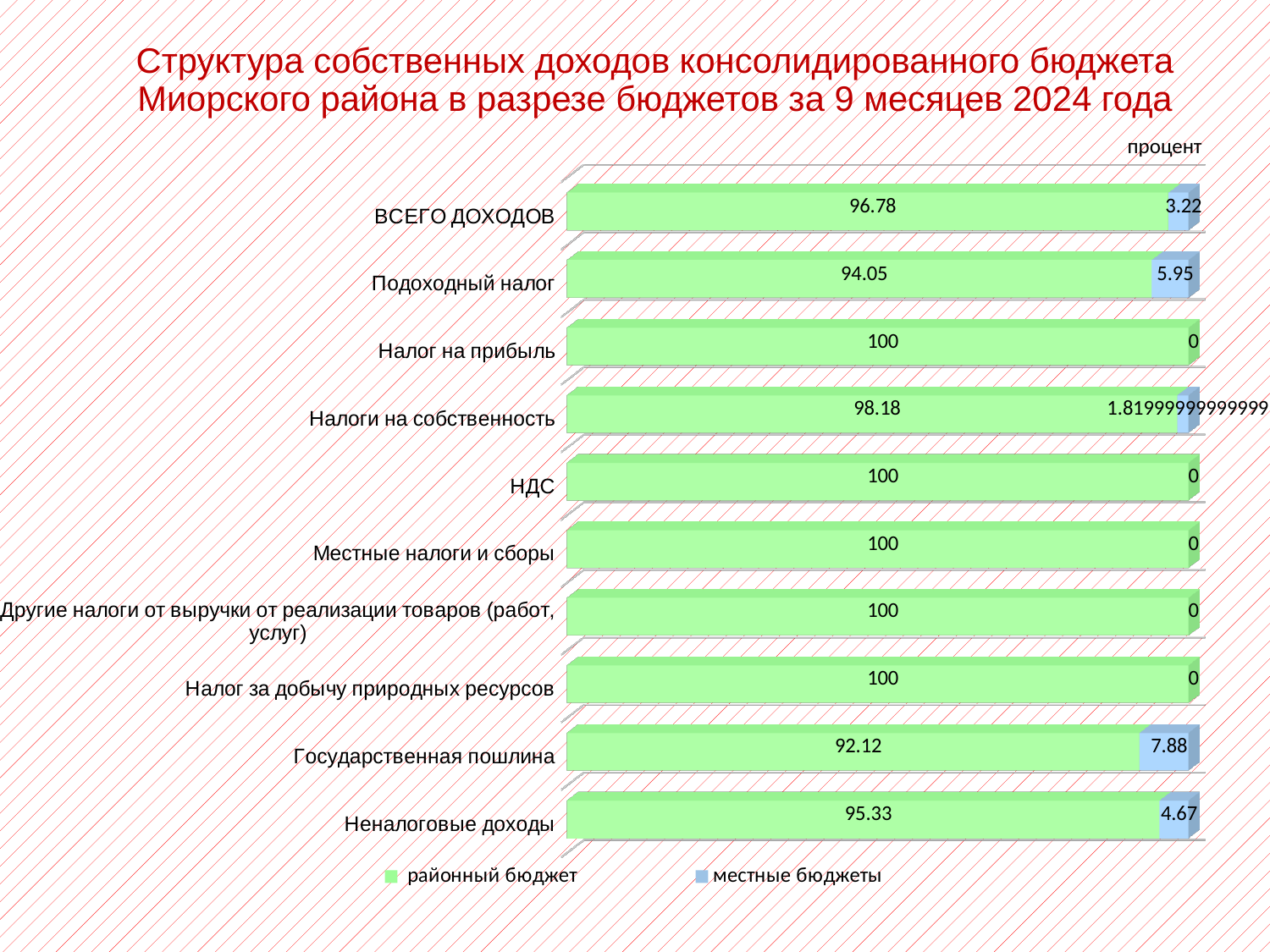
What is the difference between the районный бюджет and местные бюджеты values for ВСЕГО ДОХОДОВ? 93.56 What is the value for местные бюджеты for Неналоговые доходы? 4.67 Which is larger: the местные бюджеты value for Подоходный налог or for Неналоговые доходы? Подоходный налог What is the value for местные бюджеты for Подоходный налог? 5.95 What is the value for районный бюджет for Государственная пошлина? 92.12 How many series does the legend list? 2 What kind of chart is shown on the slide? Stacked bar chart Which category has the lowest value for районный бюджет? Государственная пошлина How many categories are shown in the chart? 10 Which category has the highest value for местные бюджеты? Государственная пошлина What is the total of the stacked bar for Государственная пошлина? 100 What is the value for районный бюджет for ВСЕГО ДОХОДОВ? 96.78